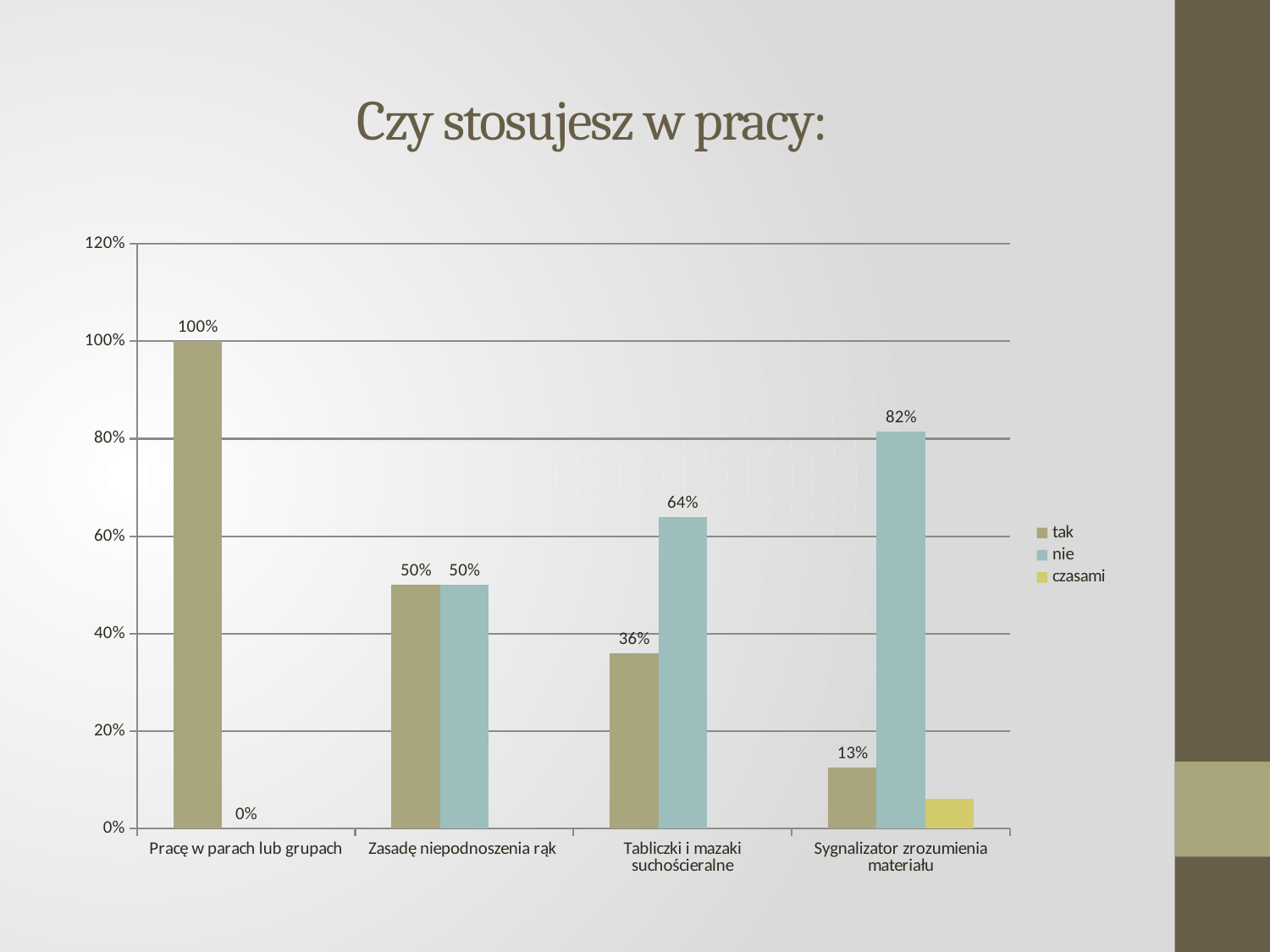
How many series does the legend list? 3 Which category has the lowest 'tak' value? Sygnalizator zrozumienia materiału Is the 'czasami' value for 'Sygnalizator zrozumienia materiału' greater or less than 20%? less What is the 'tak' value for 'Tabliczki i mazaki suchościeralne'? 36% For 'Sygnalizator zrozumienia materiału', which is larger: 'tak' or 'nie'? nie Which category has the highest 'tak' value? Pracę w parach lub grupach What type of chart is shown on the slide? bar chart What is the 'nie' value for 'Pracę w parach lub grupach'? 0% What is the difference between the 'nie' and 'tak' values for 'Tabliczki i mazaki suchościeralne'? 28% How many categories are shown on the x axis? 4 What is the 'tak' value for 'Pracę w parach lub grupach'? 100% What is the 'nie' value for 'Sygnalizator zrozumienia materiału'? 82%